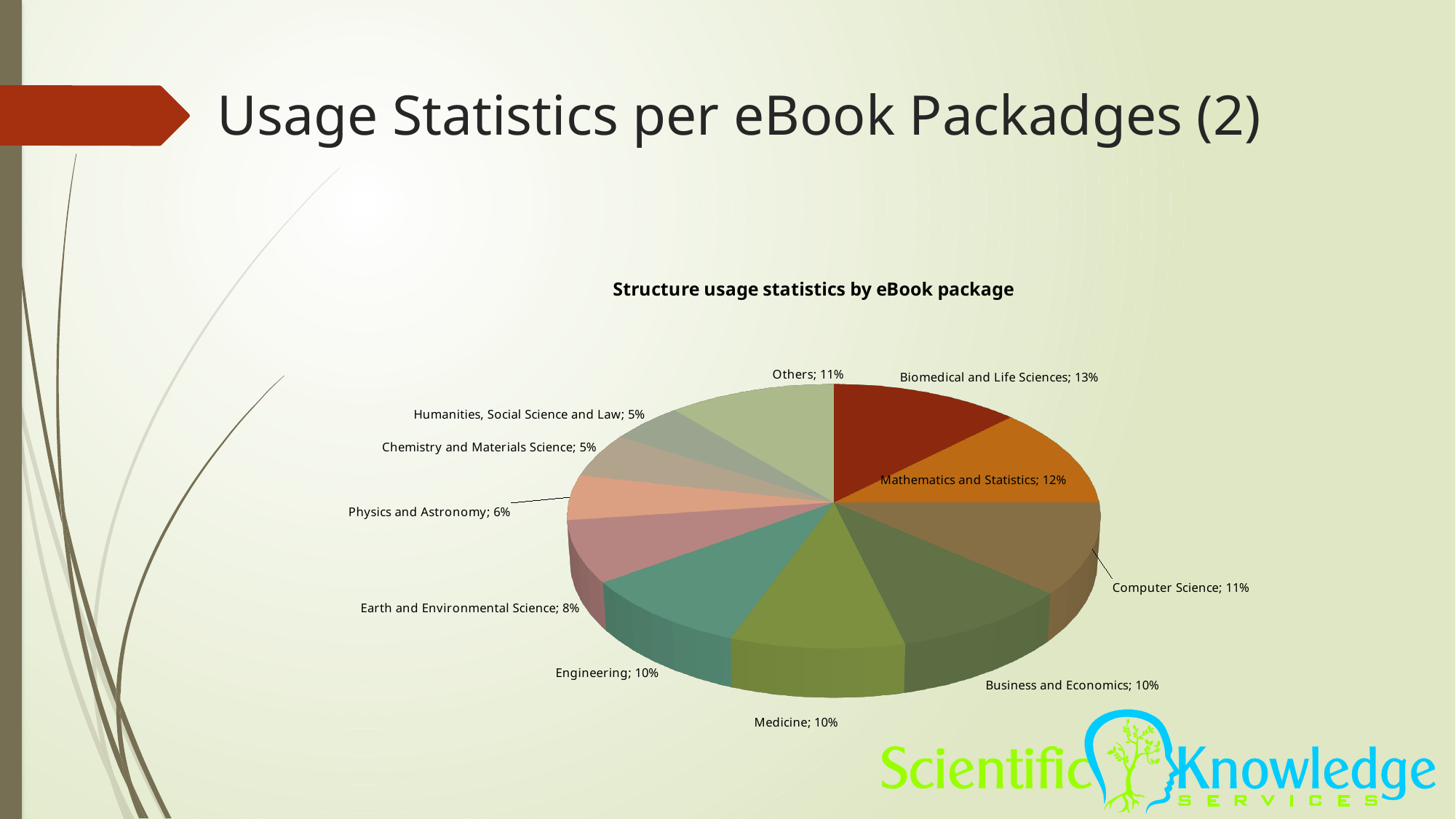
Which category has the largest share? Biomedical and Life Sciences What share does Physics and Astronomy have? 6% How many categories are shown in the pie chart? 11 Which is larger, the share for Engineering or the share for Earth and Environmental Science? Engineering What is the title of the chart? Structure usage statistics by eBook package What share does Biomedical and Life Sciences have? 13% What share does Mathematics and Statistics have? 12% What kind of chart is shown on the slide? Pie chart What share does Earth and Environmental Science have? 8% What is the difference between the shares of Biomedical and Life Sciences and Computer Science? 2% What share does Others have? 11% What is the difference between the shares of Mathematics and Statistics and Chemistry and Materials Science? 7%